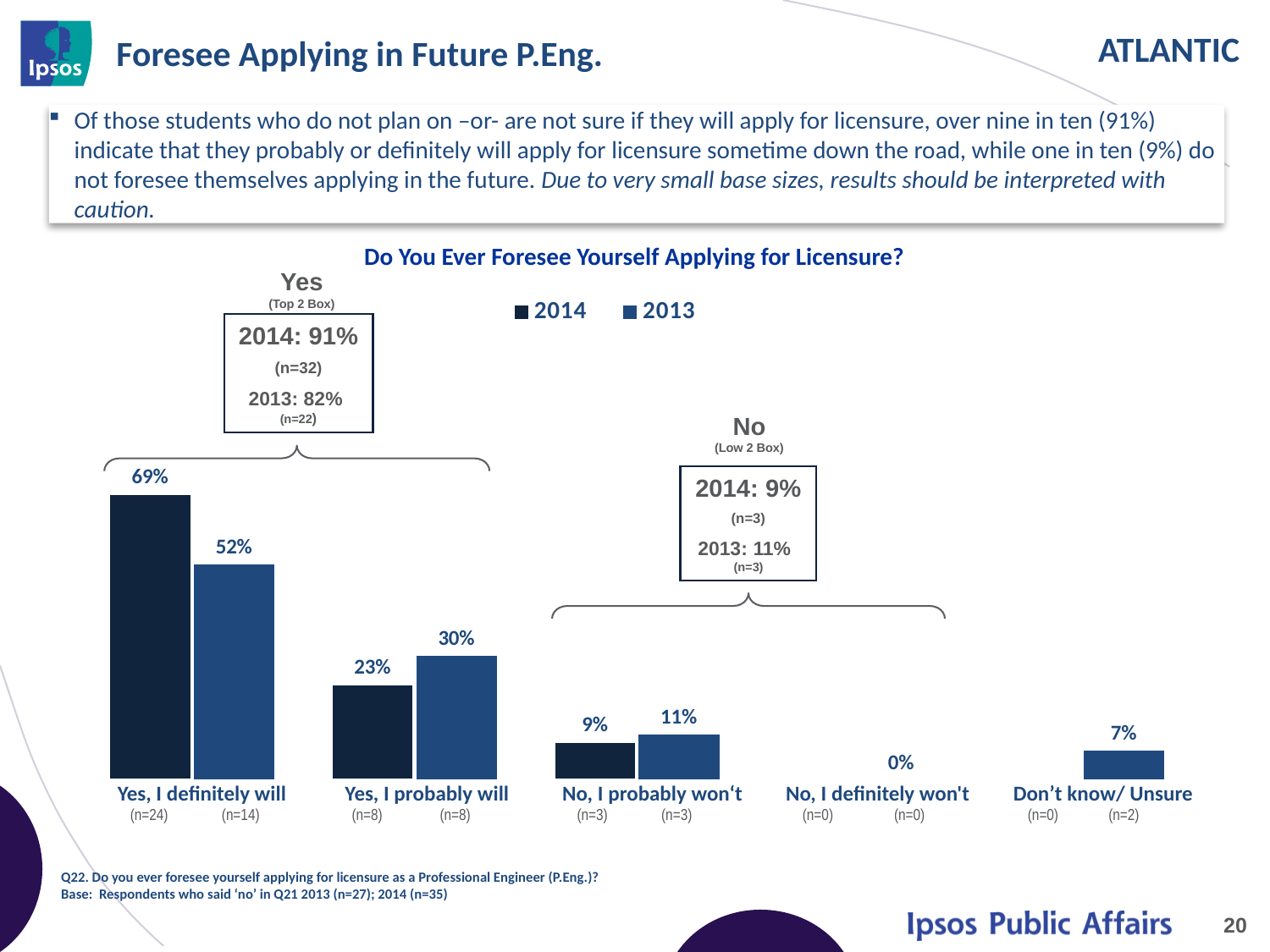
Which category has the highest 2014 value? Yes, I definitely will What is the 2014 value for "Yes, I definitely will"? 69% What is the 2013 value for "Yes, I probably will"? 30% What kind of chart is shown? Bar chart How many response categories are shown on the x axis? 5 What is the 2014 Top 2 Box (Yes) value shown in the callout? 91% For "Yes, I probably will", which year has the larger value, 2014 or 2013? 2013 How many series does the legend list? 2 What is the title of the chart? Do You Ever Foresee Yourself Applying for Licensure? What is the difference between the 2014 and 2013 values for "Yes, I definitely will"? 17% What is the 2013 value for "Don't know/ Unsure"? 7% What is the 2014 value for "No, I probably won't"? 9%